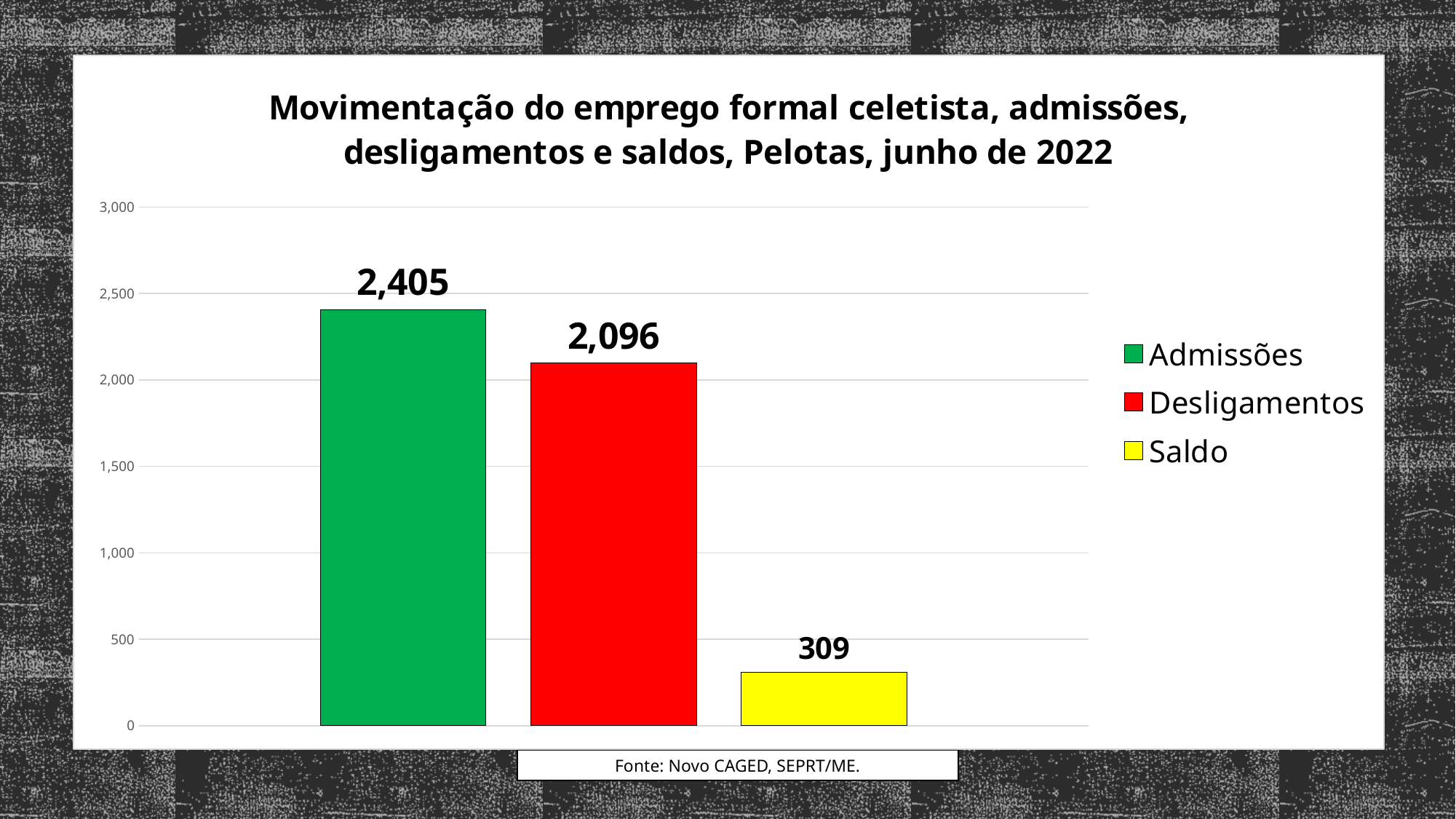
Which is larger, Admissões or Desligamentos? Admissões How many bars are plotted in the chart? 3 What kind of chart is shown on the slide? bar chart Is the value for Saldo greater or less than 500? less Which series has the highest value? Admissões What colour is the bar for Saldo? yellow What is the value for Admissões? 2,405 What is the value for Desligamentos? 2,096 How many series does the legend list? 3 What is the difference between Admissões and Desligamentos? 309 What is the value for Saldo? 309 Which series has the lowest value? Saldo